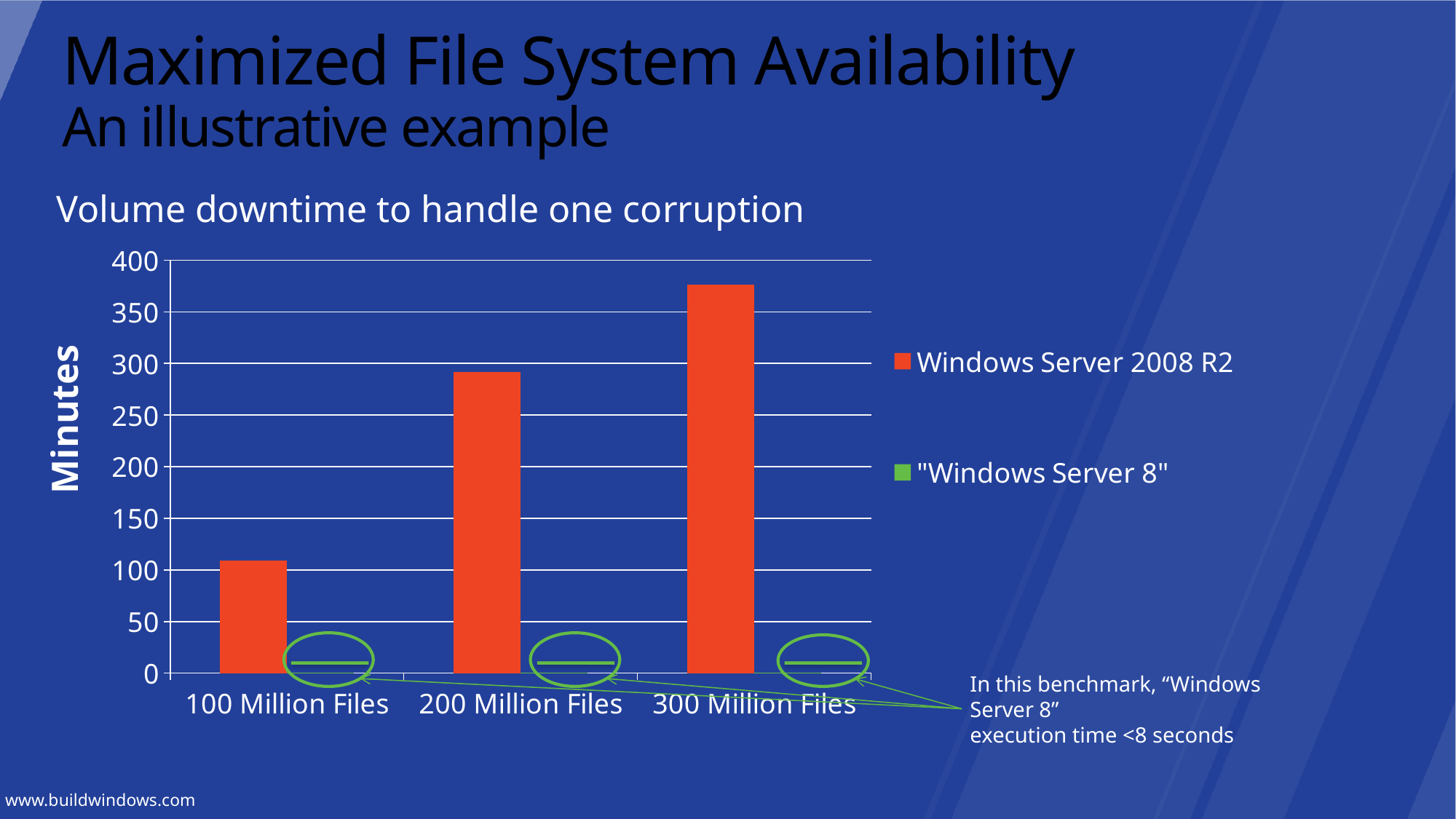
Do the Windows Server 2008 R2 values rise or fall as the number of files increases along the x axis? rise Is the Windows Server 2008 R2 value for 100 Million Files greater or less than 150? less Is the Windows Server 2008 R2 value for 300 Million Files greater or less than 350? greater Which is larger for 200 Million Files: the Windows Server 2008 R2 value or the "Windows Server 8" value? Windows Server 2008 R2 How many series does the chart legend list? 2 What is the label on the vertical axis of the chart? Minutes What kind of chart is shown on the slide? bar chart Is the "Windows Server 8" value for 300 Million Files greater or less than 50? less Which category has the highest Windows Server 2008 R2 value? 300 Million Files Which category has the lowest Windows Server 2008 R2 value? 100 Million Files How many categories are shown on the x axis of the chart? 3